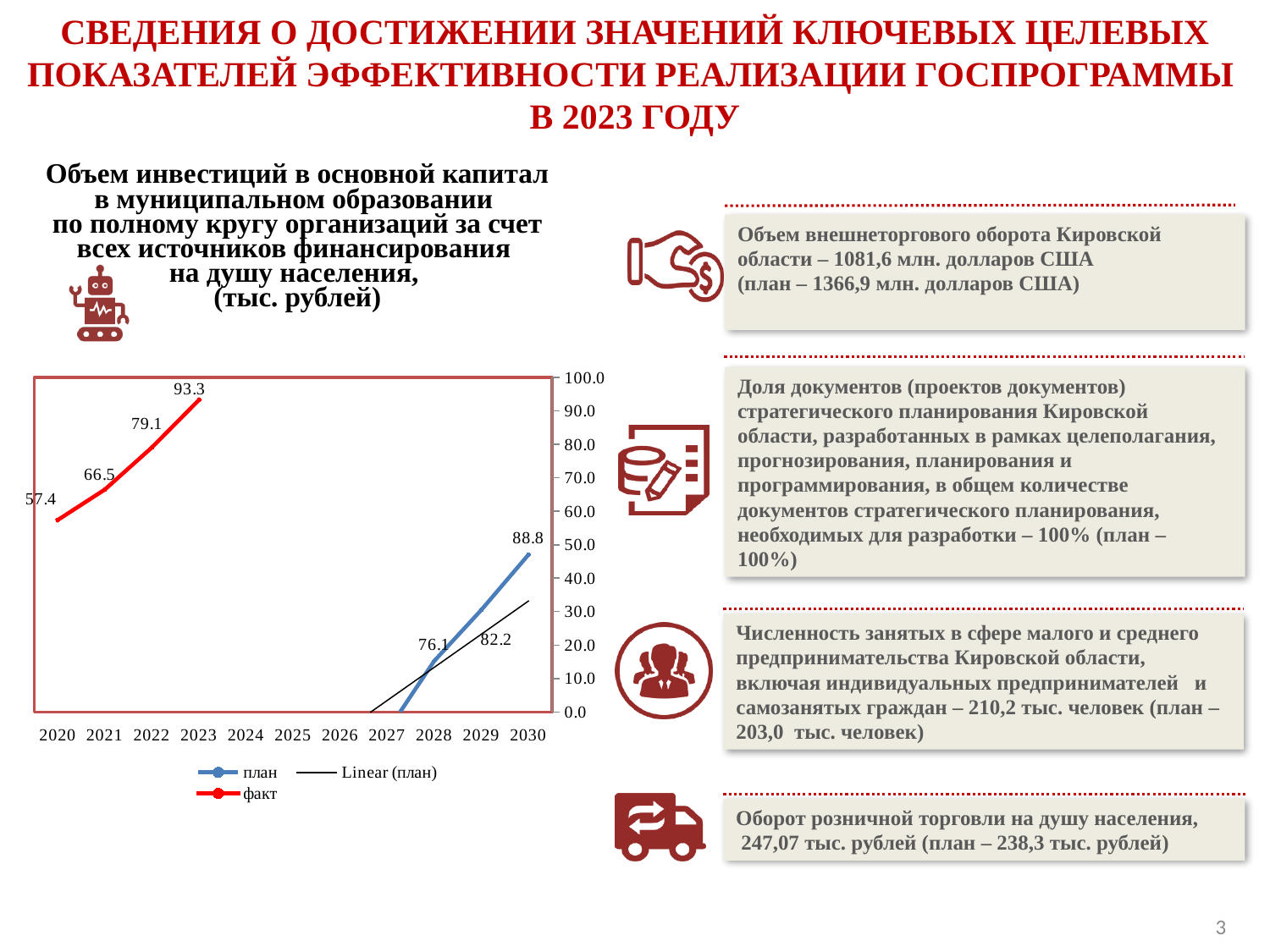
What is the value of the факт series for 2020? 57.4 What is the value of the факт series for 2023? 93.3 What is the value of the план series for 2028? 76.1 What is the value of the план series for 2030? 88.8 Which year has the highest labelled value for the факт series? 2023 Which is larger: the факт value for 2022 or the факт value for 2021? 2022 (79.1) What type of chart is shown on the slide? line chart What is the difference between the факт values for 2023 and 2020? 35.9 Which year has the lowest labelled value for the план series? 2028 How many entries does the chart legend list? 3 What is the difference between the план values for 2030 and 2028? 12.7 Does the факт series rise or fall from 2020 to 2023? rises